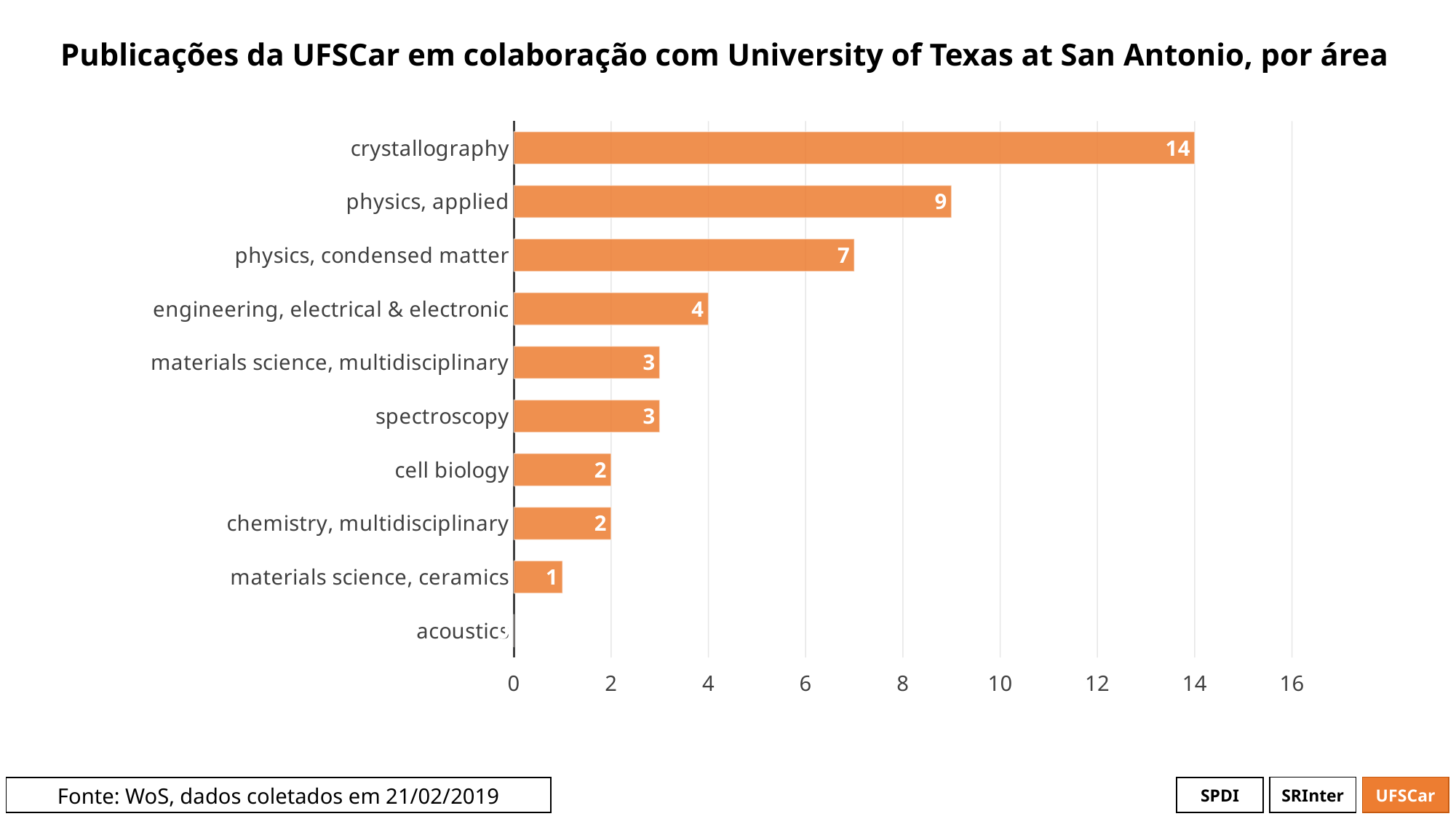
What is the difference between the values for crystallography and physics, applied? 5 What is the value for materials science, ceramics? 1 Which area has the highest number of publications? crystallography What is the difference between the values for spectroscopy and cell biology? 1 Which is larger, the value for physics, condensed matter or the value for engineering, electrical & electronic? physics, condensed matter What kind of chart is shown on the slide? bar chart What is the value for engineering, electrical & electronic? 4 What is the value for physics, applied? 9 What is the value for physics, condensed matter? 7 How many areas (categories) are listed on the chart? 10 What is the title of the chart? Publicações da UFSCar em colaboração com University of Texas at San Antonio, por área How many publications are shown for crystallography? 14